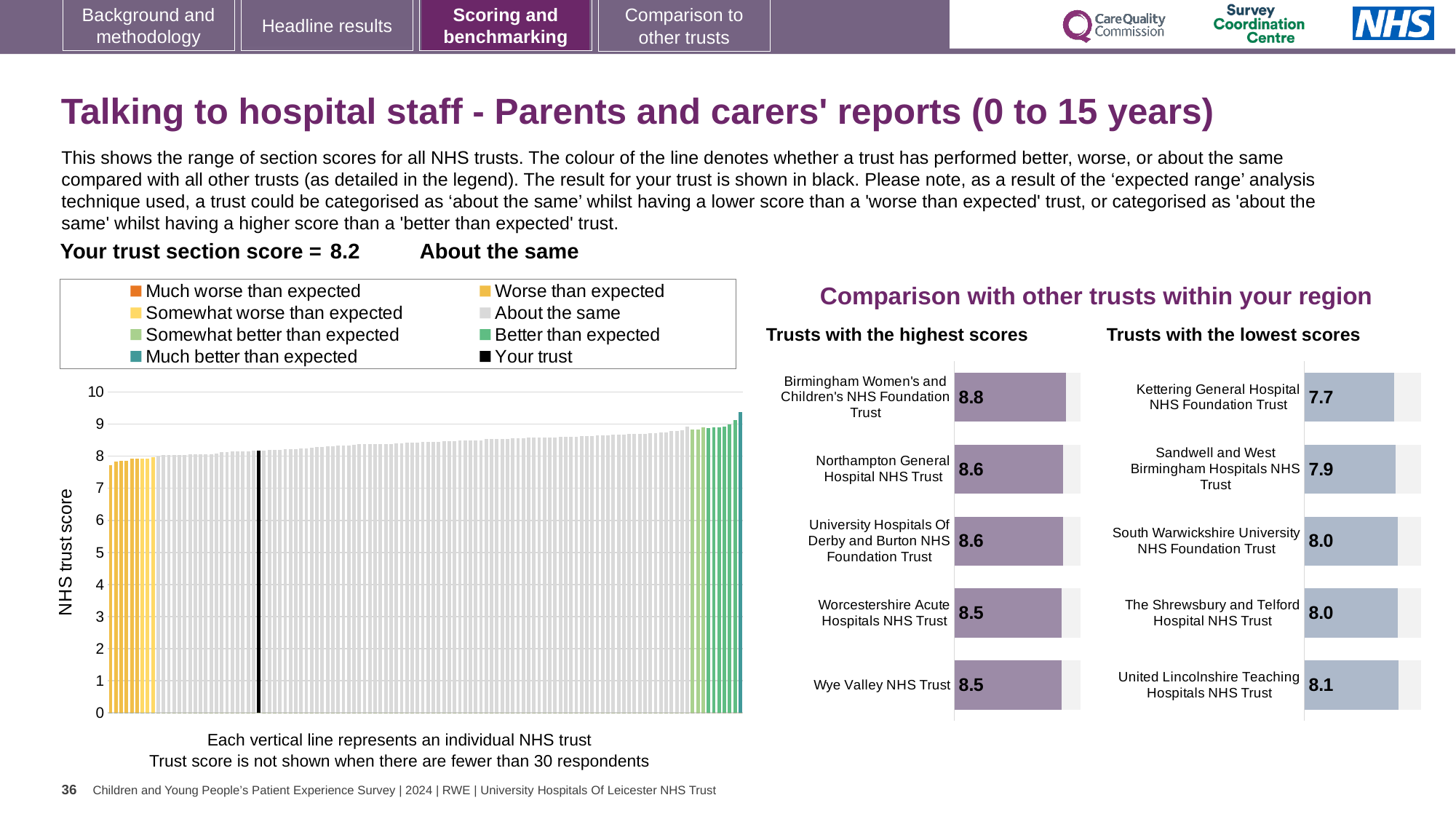
In the 'Trusts with the highest scores' chart, which trust has the highest score? Birmingham Women's and Children's NHS Foundation Trust How many trusts are shown in the 'Trusts with the lowest scores' chart? 5 In the 'Trusts with the lowest scores' chart, what is the score for Kettering General Hospital NHS Foundation Trust? 7.7 In the 'Trusts with the lowest scores' chart, which trust has the lowest score? Kettering General Hospital NHS Foundation Trust In the main chart on the left, do the trust scores rise or fall from left to right? rise In the main chart on the left, is the value for the black 'Your trust' line greater or less than 5? greater In the 'Trusts with the lowest scores' chart, which has the higher score: Kettering General Hospital NHS Foundation Trust or United Lincolnshire Teaching Hospitals NHS Trust? United Lincolnshire Teaching Hospitals NHS Trust In the 'Trusts with the lowest scores' chart, what is the difference between the scores of United Lincolnshire Teaching Hospitals NHS Trust and Kettering General Hospital NHS Foundation Trust? 0.4 In the 'Trusts with the highest scores' chart, what is the score for Birmingham Women's and Children's NHS Foundation Trust? 8.8 In the 'Trusts with the highest scores' chart, what is the difference between the scores of Birmingham Women's and Children's NHS Foundation Trust and Wye Valley NHS Trust? 0.3 In the 'Trusts with the highest scores' chart, which has the higher score: Northampton General Hospital NHS Trust or Worcestershire Acute Hospitals NHS Trust? Northampton General Hospital NHS Trust How many entries does the legend of the main chart on the left list? 8